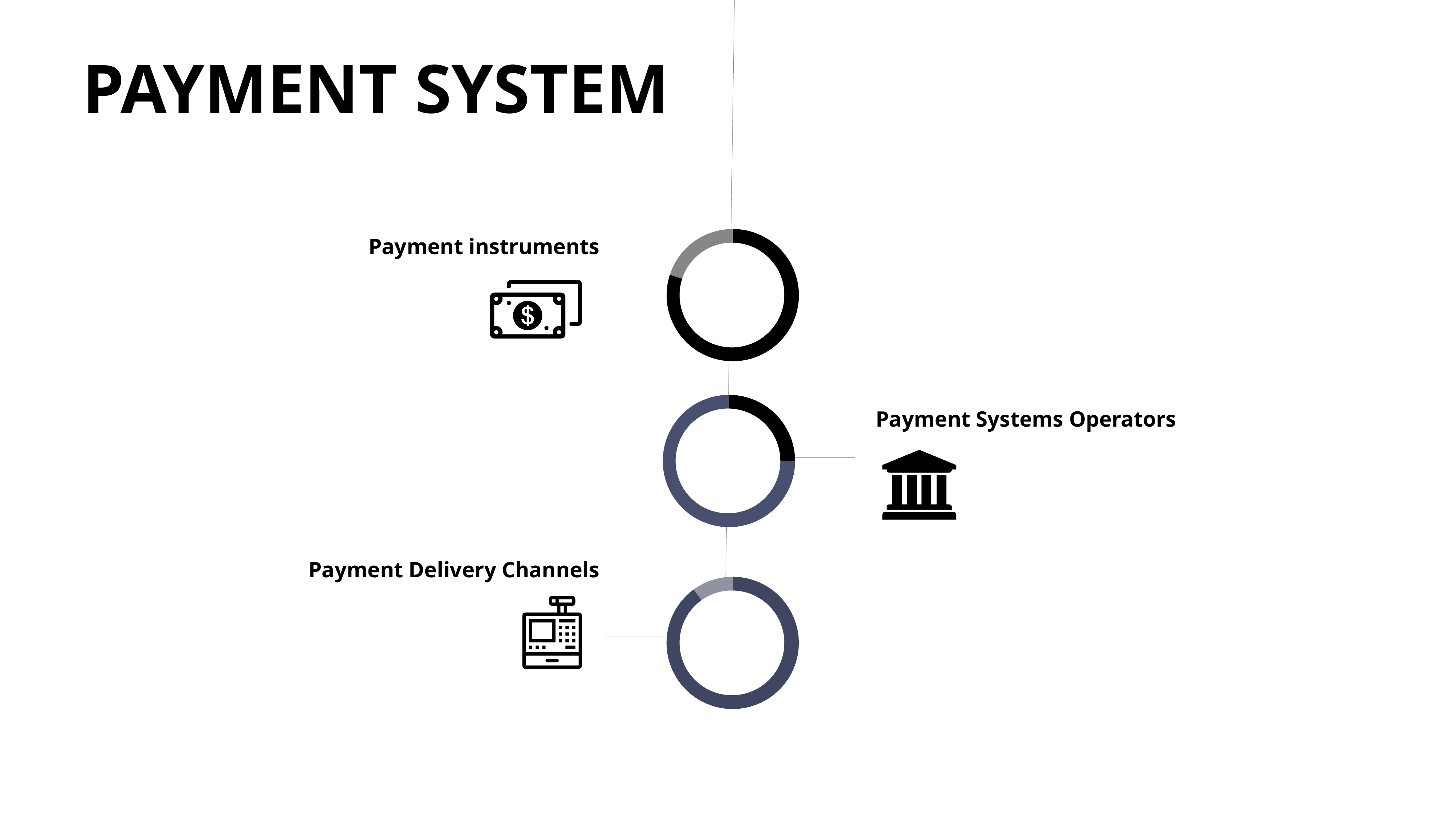
What kind of chart is shown next to the label 'Payment Delivery Channels'? doughnut chart In the doughnut chart next to 'Payment Delivery Channels', which segment is larger, the blue-grey one or the light grey one? the blue-grey one What kind of chart is shown next to the label 'Payment Systems Operators'? doughnut chart In the doughnut chart next to 'Payment Systems Operators', which segment is larger, the black one or the blue-grey one? the blue-grey one Which label is placed to the right of the middle doughnut chart? Payment Systems Operators In the doughnut chart next to 'Payment instruments', how many segments does the ring have? 2 How many doughnut charts are on the slide? 3 What is the title of the slide containing the three doughnut charts? PAYMENT SYSTEM In the doughnut chart next to 'Payment Systems Operators', how many segments does the ring have? 2 In the doughnut chart next to 'Payment instruments', which segment is larger, the black one or the grey one? the black one What kind of chart is shown next to the label 'Payment instruments'? doughnut chart